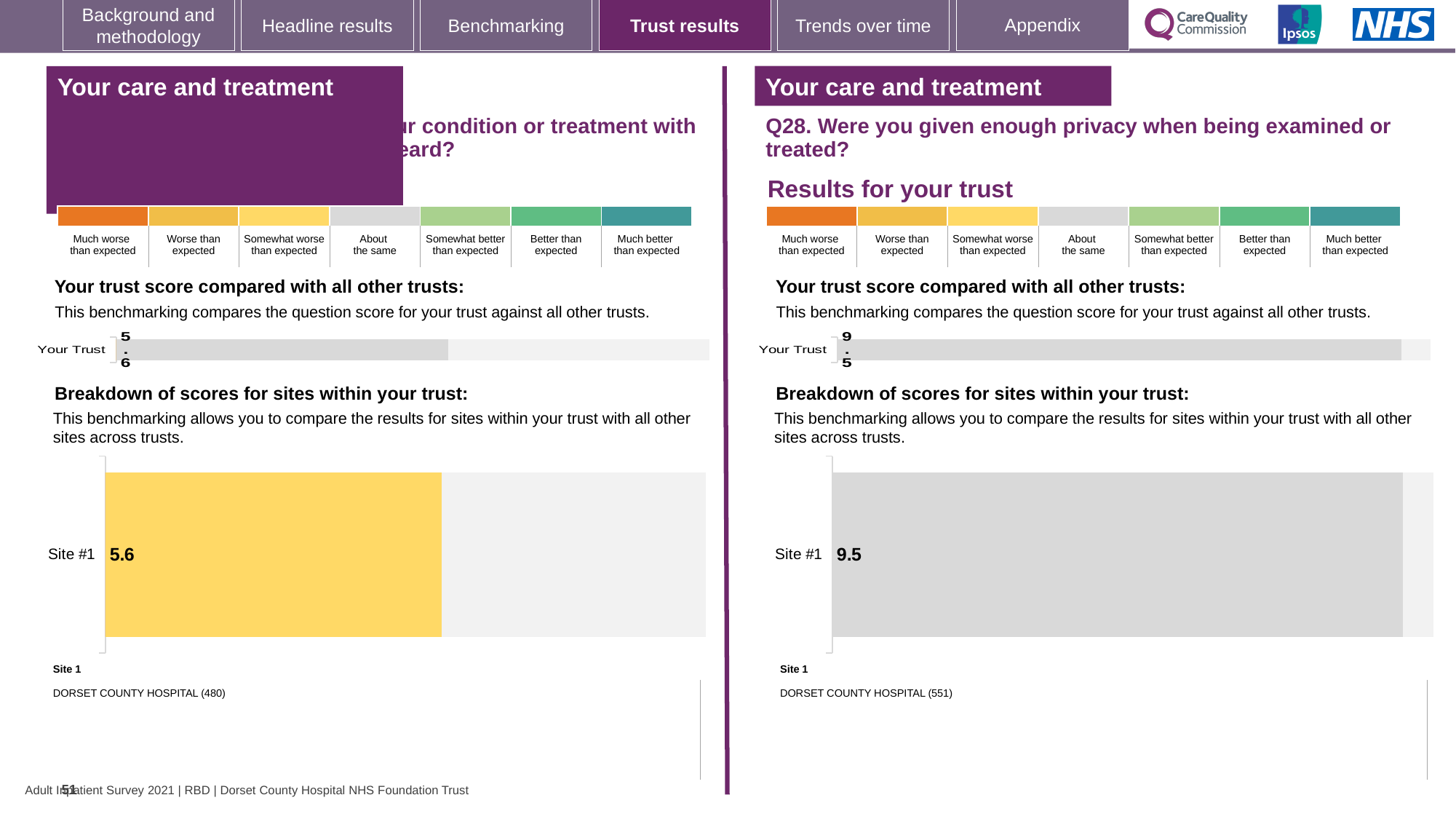
What type of chart is used for the breakdown of scores for sites within your trust on the right half of the slide? Bar chart How many sites are shown in the breakdown of scores chart on the right half of the slide (Q28)? 1 Which site name is listed under 'Site 1' on the right half of the slide (Q28)? DORSET COUNTY HOSPITAL (551) Which is larger: the Site #1 score on the left chart or the Site #1 score on the right chart (Q28)? The right chart (Q28) On the right half of the slide (Q28, privacy when being examined or treated), what is the score shown for Site #1? 9.5 On the left half of the slide, what is the 'Your Trust' score in the trust score comparison bar? 5.6 What colour is the Site #1 bar in the breakdown chart on the left half of the slide? Yellow What is the difference between the Site #1 score on the right chart (Q28) and the Site #1 score on the left chart? 3.9 On the left half of the slide, what is the score shown for Site #1 in the breakdown of scores for sites within your trust? 5.6 On the right half of the slide (Q28), what is the 'Your Trust' score in the trust score comparison bar? 9.5 How many sites are shown in the breakdown of scores chart on the left half of the slide? 1 Is the Site #1 score on the left chart greater or less than 9? less